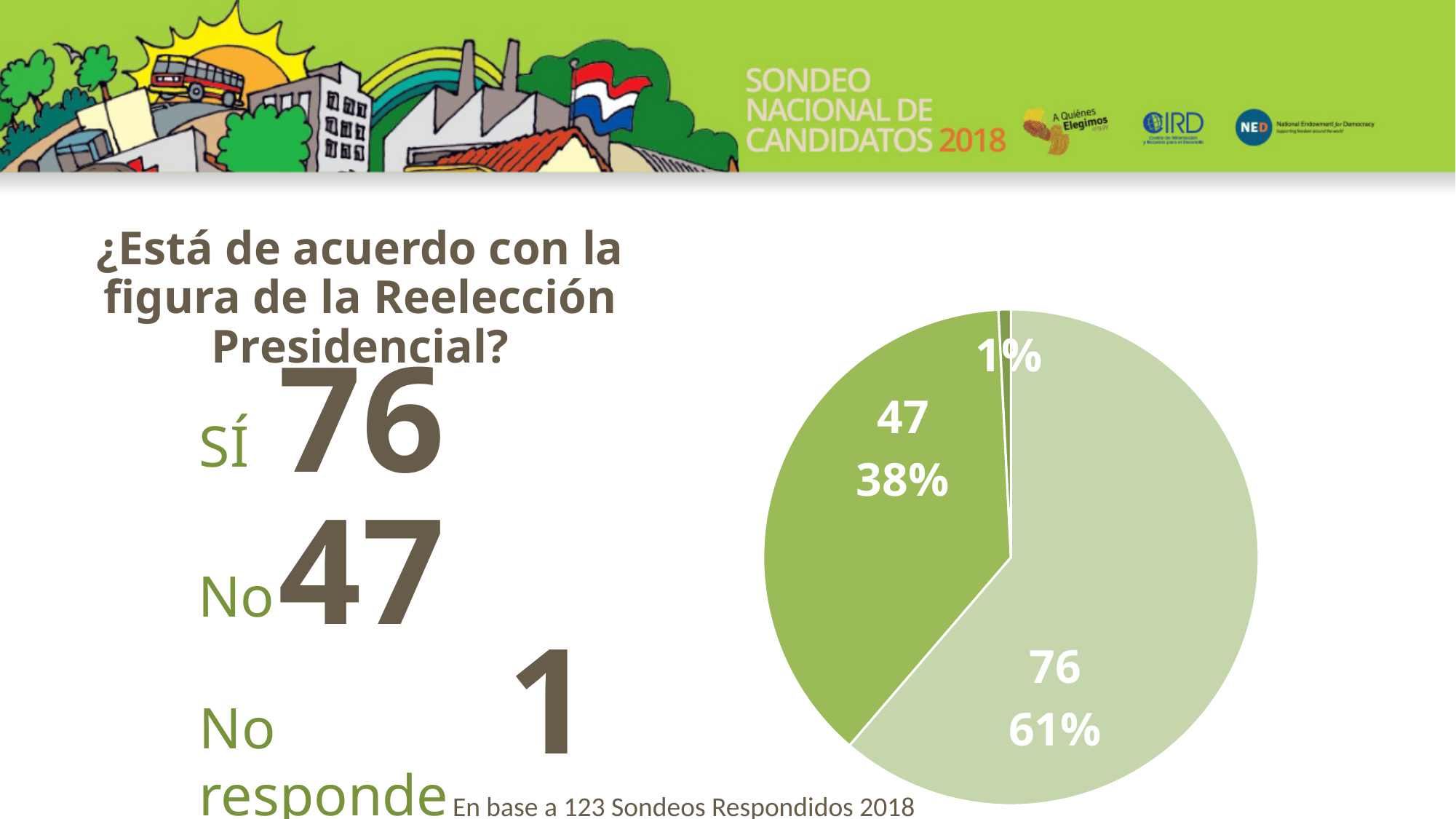
Which response has the larger count, 'Sí' or 'No'? Sí How many respondents answered 'Sí' according to the slide? 76 How many respondents answered 'No' according to the slide? 47 How many respondents are listed under 'No responde'? 1 What count is shown on the largest slice of the pie chart? 76 What percentage is shown for the smallest slice of the pie chart? 1% What is the difference between the 'Sí' count and the 'No' count? 29 How many slices does the pie chart have? 3 What percentage is shown for the slice with a count of 47? 38% What percentage is shown for the largest slice of the pie chart? 61% According to the note below the chart, how many surveys were answered? 123 What kind of chart is shown on the slide? pie chart